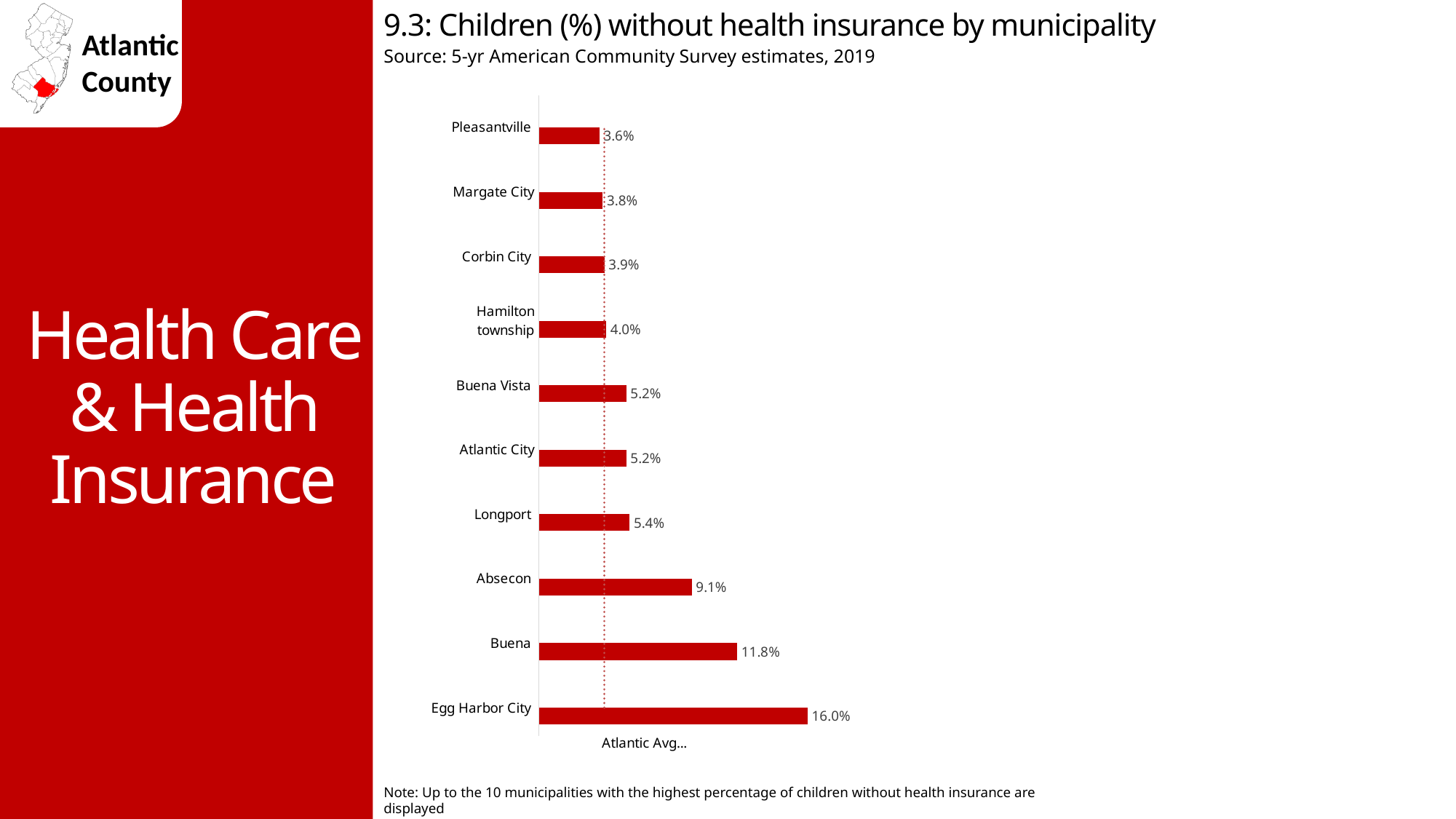
What is the source of the data shown in the chart? 5-yr American Community Survey estimates, 2019 What is the difference between the values for Absecon and Longport? 3.7% How many municipalities are shown in the chart? 10 What is the difference between the values for Egg Harbor City and Buena? 4.2% What type of chart is used on this slide? Bar chart Which municipality has the lowest percentage of children without health insurance? Pleasantville Which municipality has the highest percentage of children without health insurance? Egg Harbor City What is the value shown for Hamilton township? 4.0% What percentage of children in Egg Harbor City are without health insurance? 16.0% Which has a higher value, Longport or Corbin City? Longport What is the value shown for Absecon? 9.1% Which has a higher value, Buena or Absecon? Buena